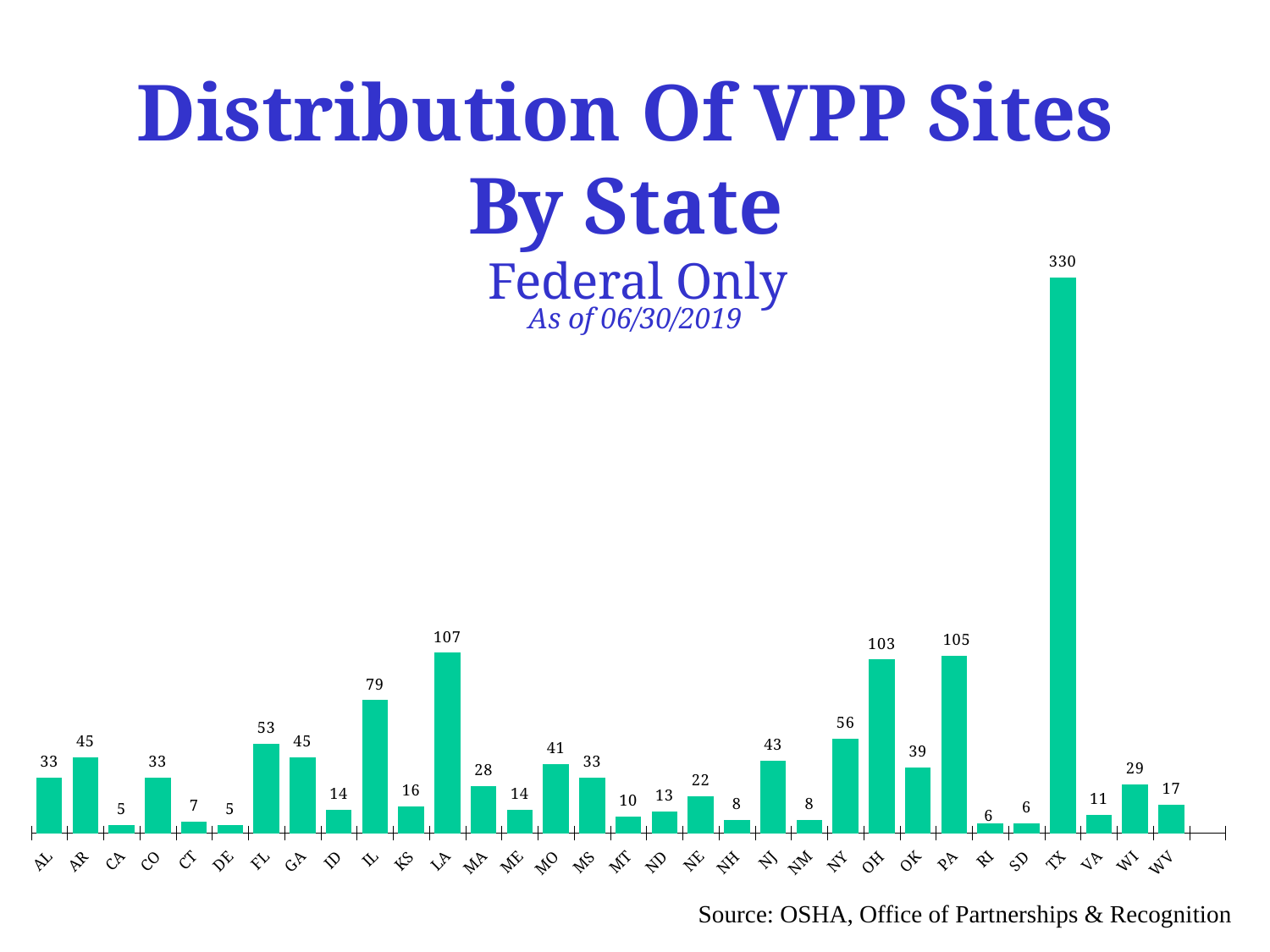
What is the number of VPP sites for LA? 107 What is the number of VPP sites for NJ? 43 What is the number of VPP sites for OH? 103 What kind of chart is shown on the slide? Bar chart What is the number of VPP sites for WV? 17 What is the title of the chart? Distribution Of VPP Sites By State Which state has the highest number of VPP sites? TX What is the difference between the values for PA and OH? 2 What is the difference between the values for TX and LA? 223 How many states are shown on the x axis? 32 What is the number of VPP sites for TX? 330 Which has more VPP sites, IL or NY? IL